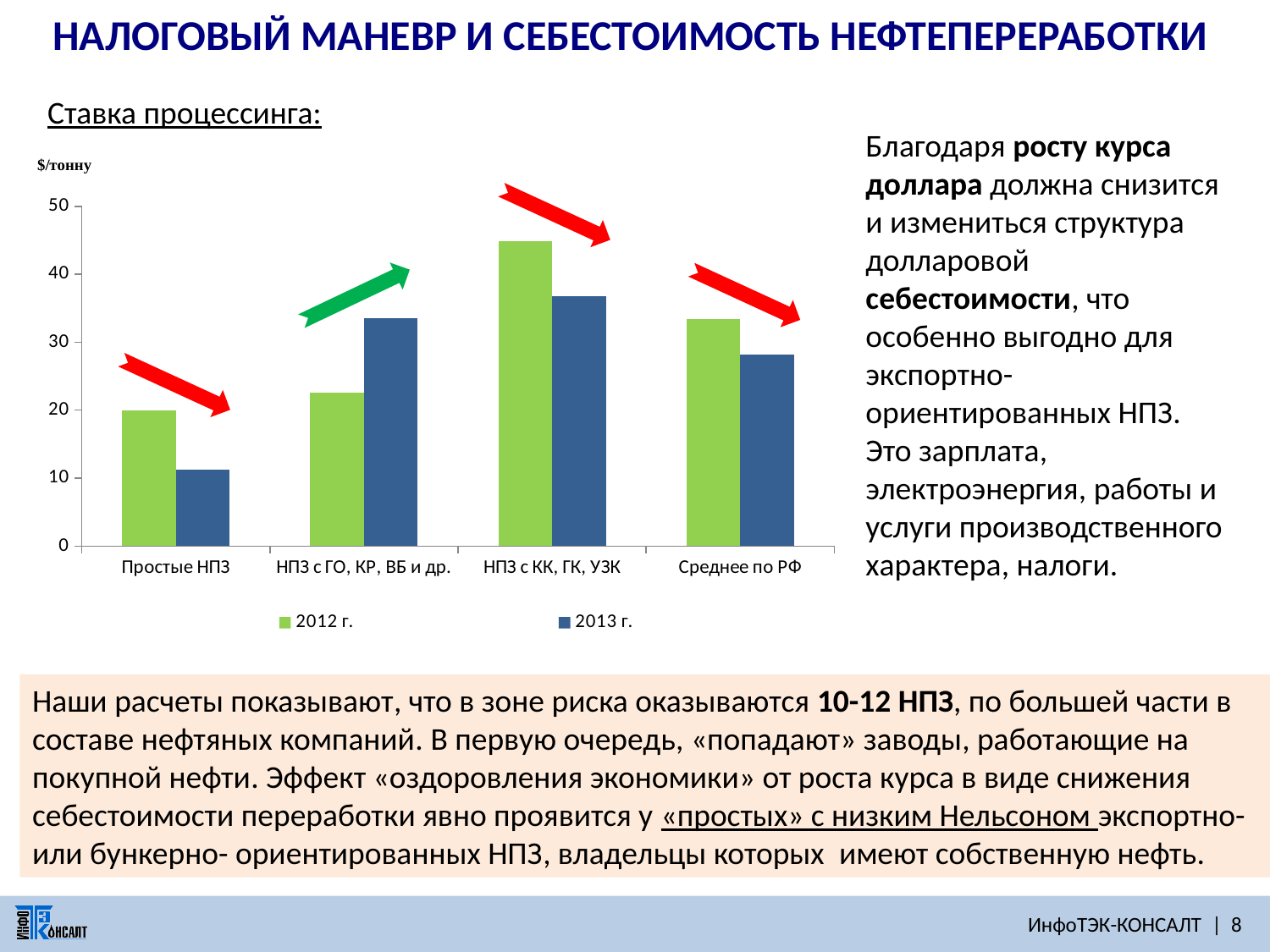
Is the 2013 г. value for НПЗ с ГО, КР, ВБ и др. greater or less than 30? greater Which category has the lowest value for the 2013 г. series? Простые НПЗ Which category has the highest value for the 2012 г. series? НПЗ с КК, ГК, УЗК For the category Простые НПЗ, which series has the larger value, 2012 г. or 2013 г.? 2012 г. How many series does the chart legend list? 2 What are the two entries in the chart legend? 2012 г. and 2013 г. For the category НПЗ с ГО, КР, ВБ и др., which series has the larger value, 2012 г. or 2013 г.? 2013 г. What unit is shown on the vertical axis of the chart? $/тонну Is the 2012 г. value for НПЗ с КК, ГК, УЗК greater or less than 40? greater What kind of chart is shown on the slide? Bar chart Is the 2013 г. value for Простые НПЗ greater or less than 20? less How many categories are shown on the x axis of the chart? 4